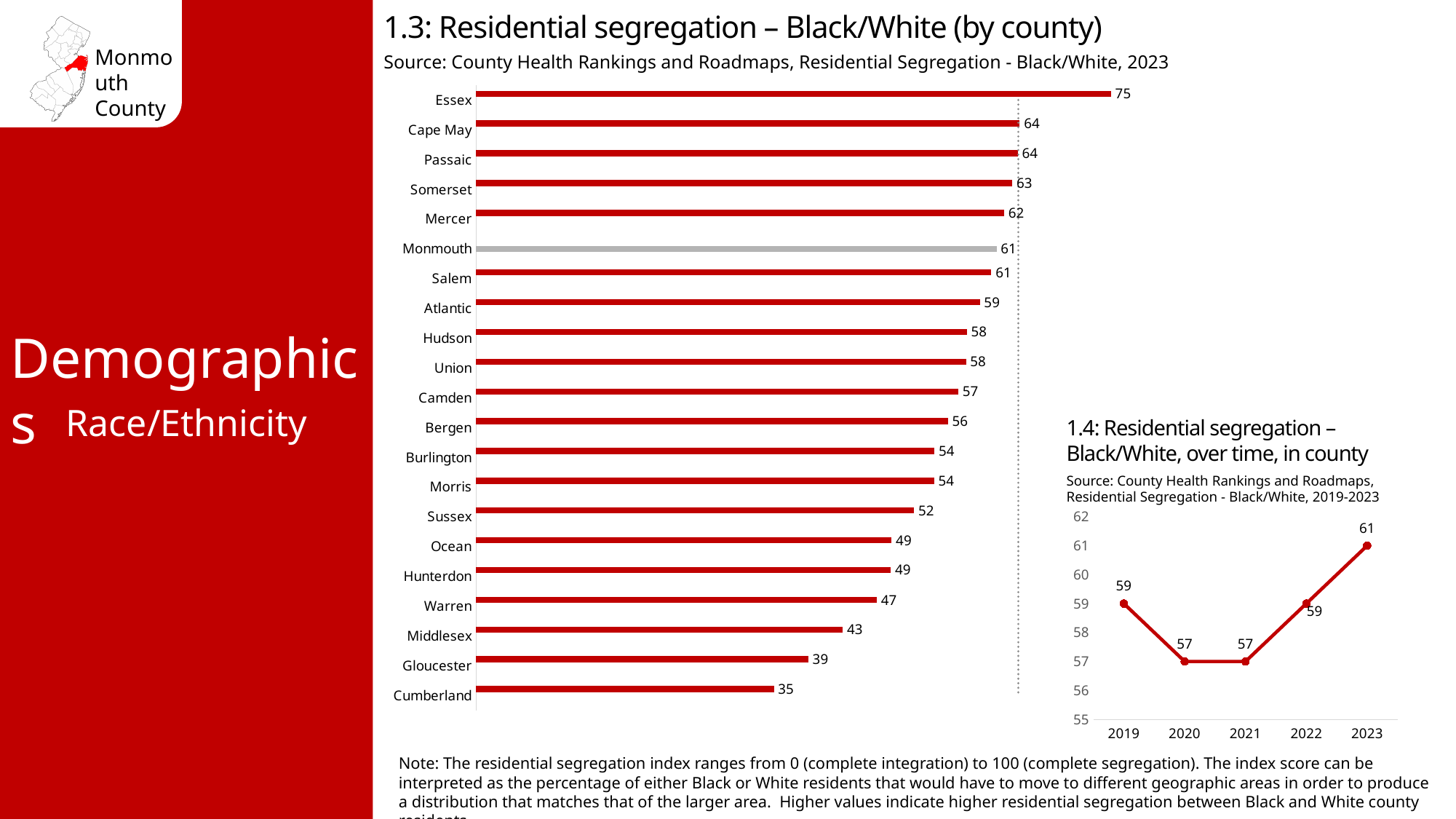
In chart 1.4 (over time), what is the difference between the values for 2023 and 2020? 4 In chart 1.3 (by county), which county has the lowest value? Cumberland In chart 1.3 (by county), which county has the highest value? Essex In chart 1.3 (by county), how many counties are shown? 21 In chart 1.3 (Residential segregation – Black/White by county), what is the value for Monmouth? 61 In chart 1.4 (Residential segregation – Black/White over time), what is the value for 2023? 61 In chart 1.4 (over time), do the values rise or fall from 2021 to 2023? Rise In chart 1.4 (over time), how many years are plotted? 5 In chart 1.3 (by county), what is the difference between the values for Essex and Cumberland? 40 What kind of chart is chart 1.3 (Residential segregation – Black/White by county)? Bar chart In chart 1.3 (by county), what is the value for Cumberland? 35 In chart 1.3 (by county), which has a larger value, Middlesex or Warren? Warren